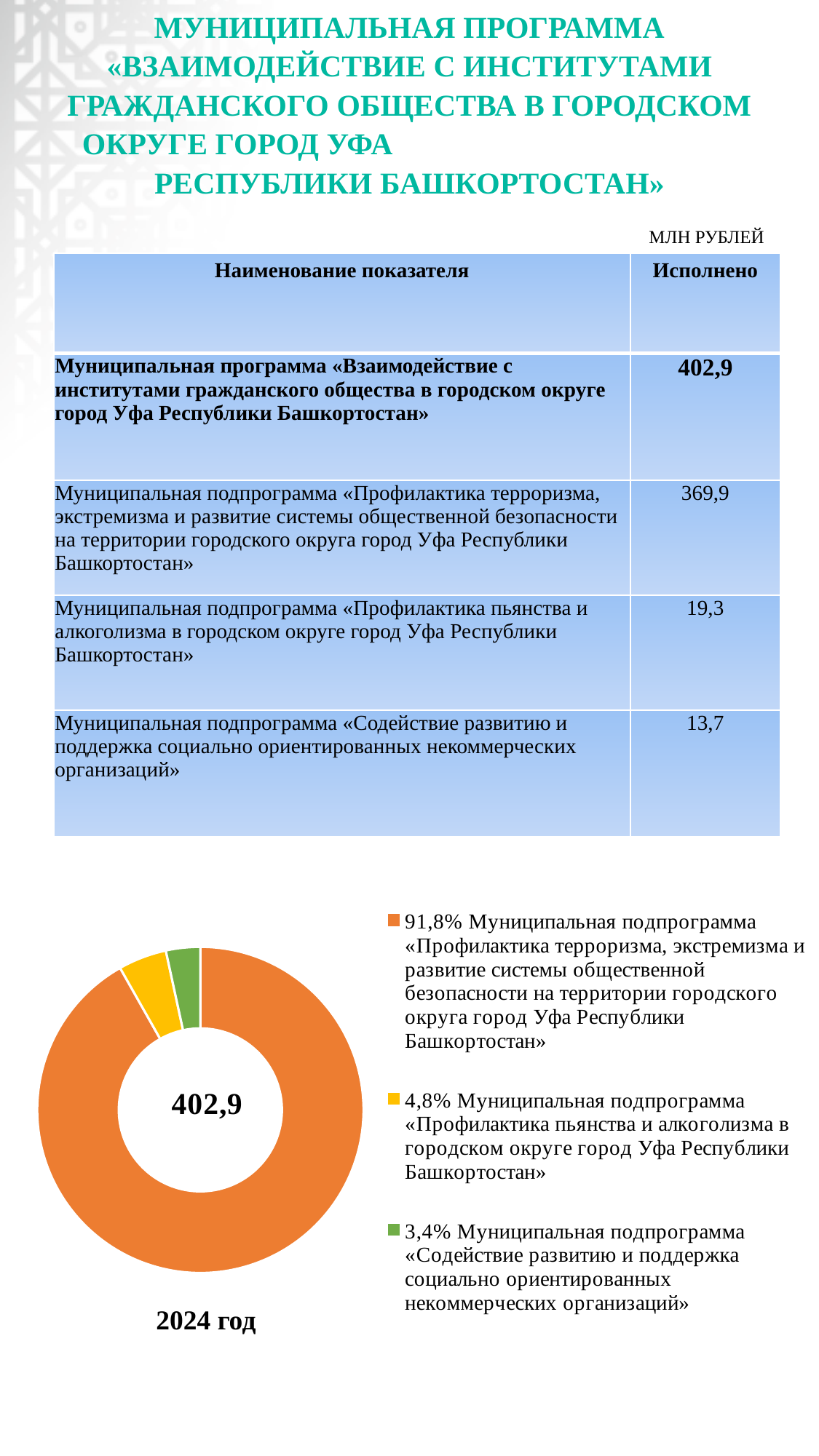
Which subprogram has the smallest slice in the doughnut chart? «Содействие развитию и поддержка социально ориентированных некоммерческих организаций» Which subprogram has the largest slice in the doughnut chart? «Профилактика терроризма, экстремизма и развитие системы общественной безопасности...» What share of the doughnut chart does the subprogram «Содействие развитию и поддержка социально ориентированных некоммерческих организаций» take? 3,4% How many slices does the doughnut chart have? 3 How many entries does the legend of the doughnut chart list? 3 What value is printed in the centre of the doughnut chart? 402,9 What share of the doughnut chart does the subprogram «Профилактика пьянства и алкоголизма...» take? 4,8% By how many percentage points does the share of «Профилактика терроризма...» exceed the share of «Профилактика пьянства и алкоголизма...» in the doughnut chart? 87,0% Which slice is larger in the doughnut chart: «Профилактика пьянства и алкоголизма...» or «Содействие развитию и поддержка социально ориентированных некоммерческих организаций»? «Профилактика пьянства и алкоголизма...» What share of the doughnut chart does the subprogram «Профилактика терроризма, экстремизма и развитие системы общественной безопасности...» take? 91,8% What kind of chart is shown at the bottom of the slide? doughnut (pie) chart What colour is the largest slice of the doughnut chart? orange